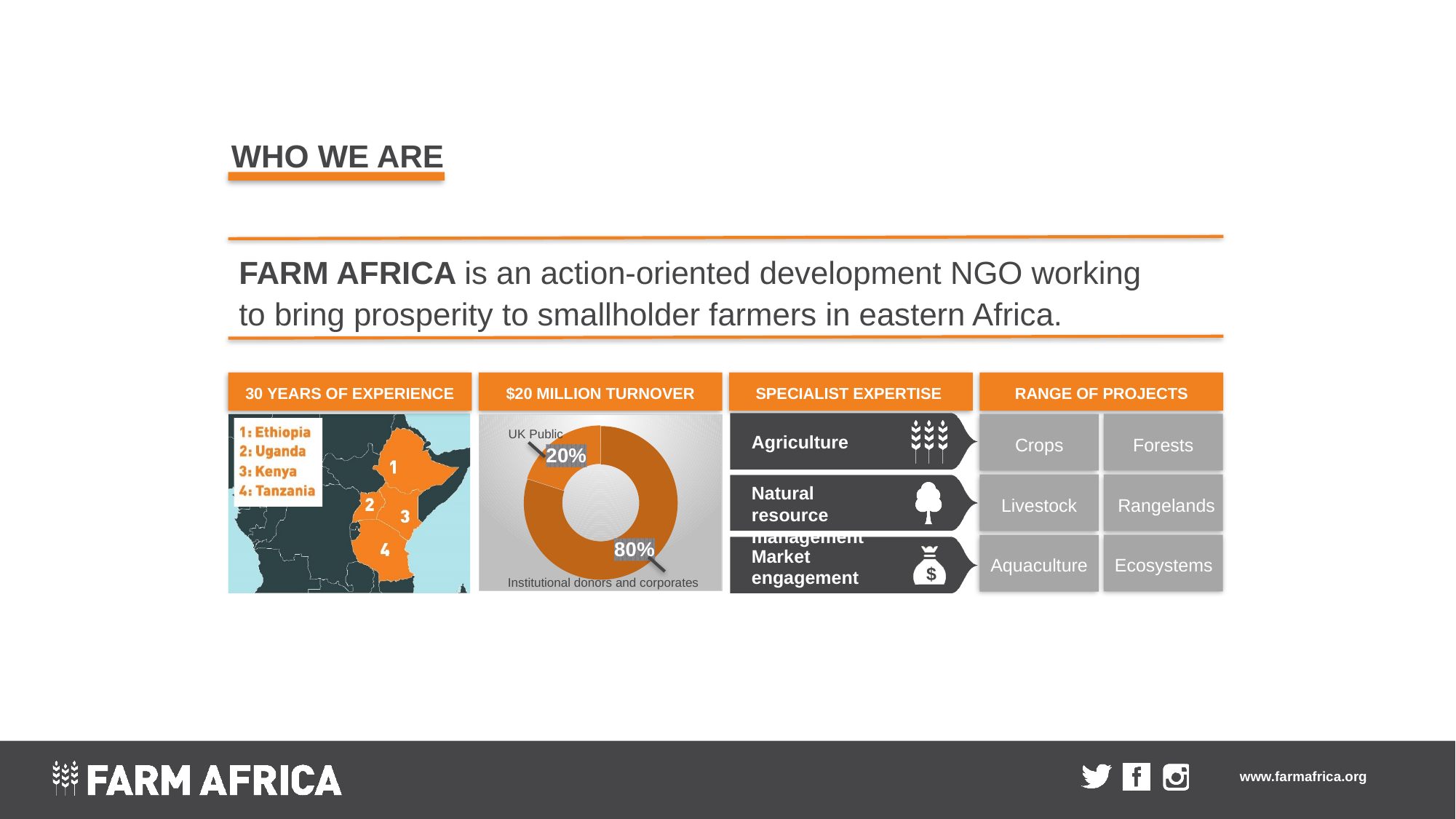
In the turnover donut chart, what is the difference in percentage points between Institutional donors and corporates and UK Public? 60 In the turnover donut chart, what share is labelled for UK Public? 20% In the turnover donut chart, which source accounts for the smallest share? UK Public In the turnover donut chart, which source accounts for the largest share? Institutional donors and corporates In the turnover donut chart, which is larger: the UK Public share or the Institutional donors and corporates share? Institutional donors and corporates In the turnover donut chart, what share is labelled for Institutional donors and corporates? 80% What colour are the slices of the turnover donut chart? Orange In the turnover donut chart, what do the two labelled shares add up to? 100% What kind of chart is shown under the "$20 MILLION TURNOVER" heading? Donut (pie) chart What heading appears above the donut chart? $20 MILLION TURNOVER How many slices does the turnover donut chart have? 2